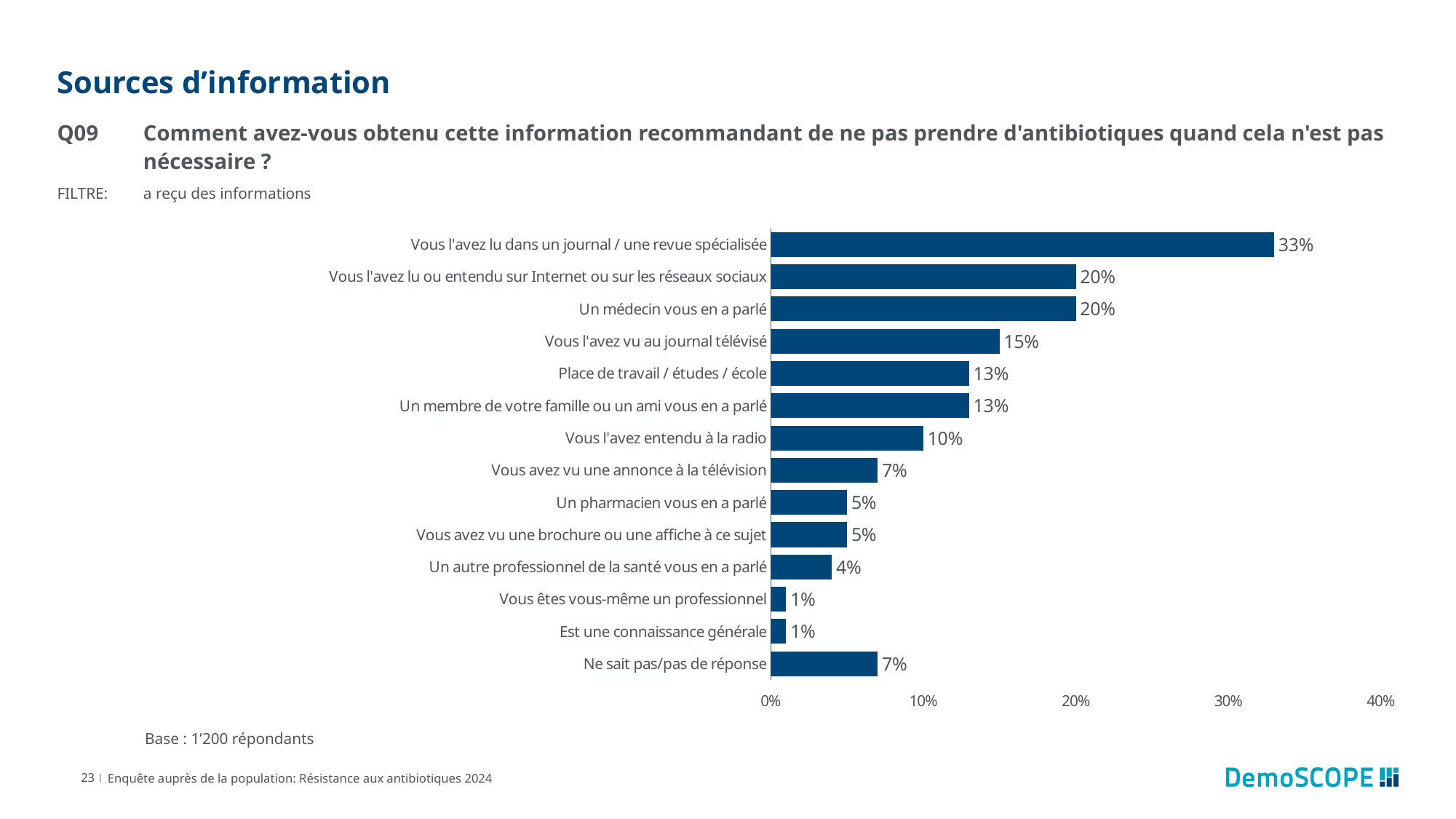
How many categories are shown in the chart? 14 Which category has the highest value? Vous l'avez lu dans un journal / une revue spécialisée Which is larger: "Vous avez vu une annonce à la télévision" or "Un autre professionnel de la santé vous en a parlé"? Vous avez vu une annonce à la télévision Is the value for "Vous l'avez lu ou entendu sur Internet ou sur les réseaux sociaux" greater or less than 30%? less What is the value for "Ne sait pas/pas de réponse"? 7% What is the base (number of respondents) stated below the chart? 1'200 répondants What kind of chart is shown on the slide? bar chart What is the value for "Vous l'avez lu dans un journal / une revue spécialisée"? 33% What is the difference between "Vous l'avez lu dans un journal / une revue spécialisée" and "Un médecin vous en a parlé"? 13% What is the value for "Un pharmacien vous en a parlé"? 5% What is the value for "Vous l'avez entendu à la radio"? 10% What is the difference between "Vous l'avez vu au journal télévisé" and "Vous l'avez entendu à la radio"? 5%